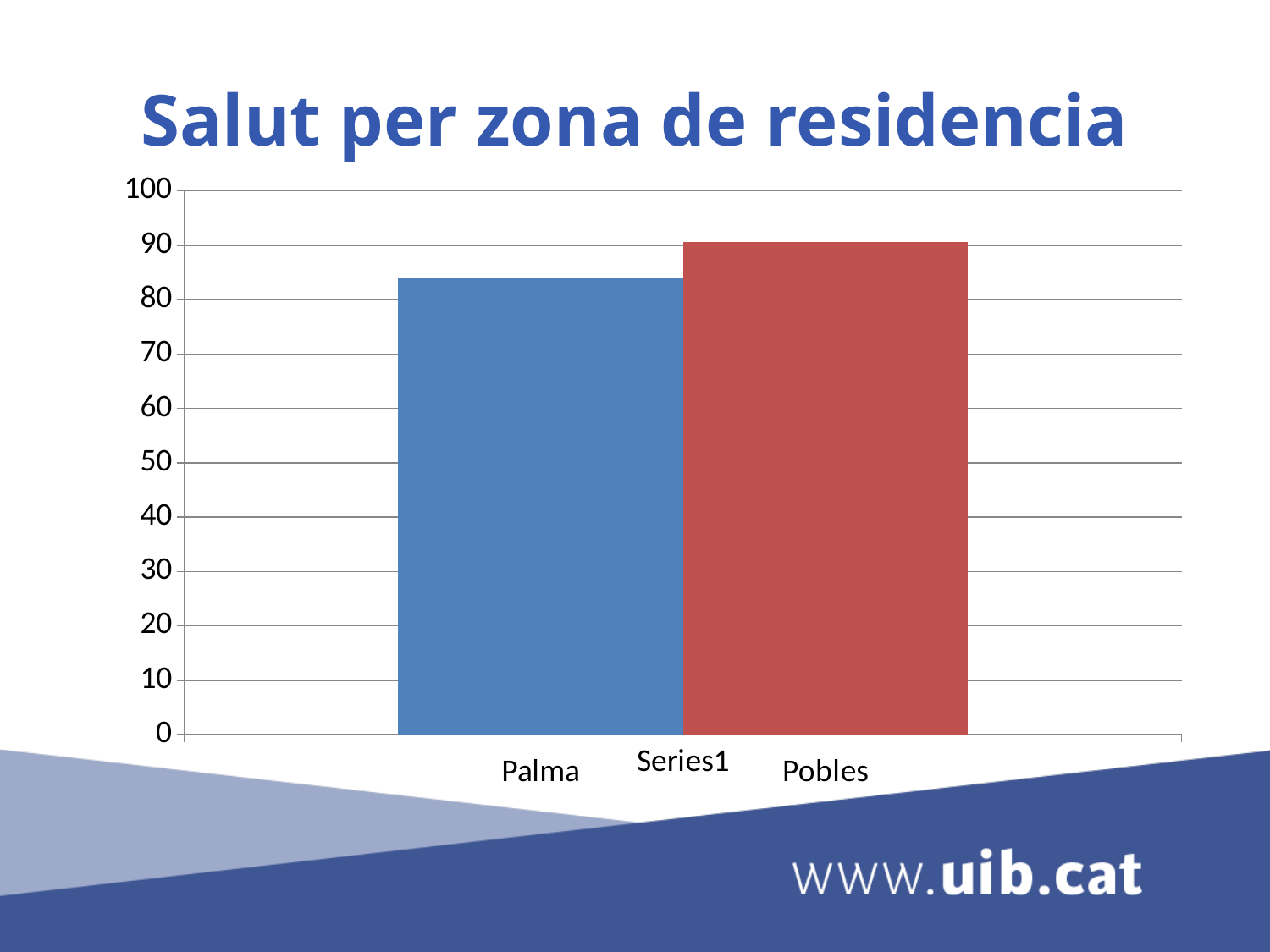
Is the value for Palma greater or less than 90? less Is the value for Pobles greater or less than 80? greater How many bars are plotted in the chart? 2 Which is larger, the value for Palma or the value for Pobles? Pobles What kind of chart is shown on the slide? bar chart What colour is the bar for Pobles? red Is the value for Palma greater or less than 80? greater Which category has the lowest bar in the chart? Palma Which category has the highest bar in the chart? Pobles What is the highest value shown on the vertical axis? 100 What is the title of the chart on the slide? Salut per zona de residencia